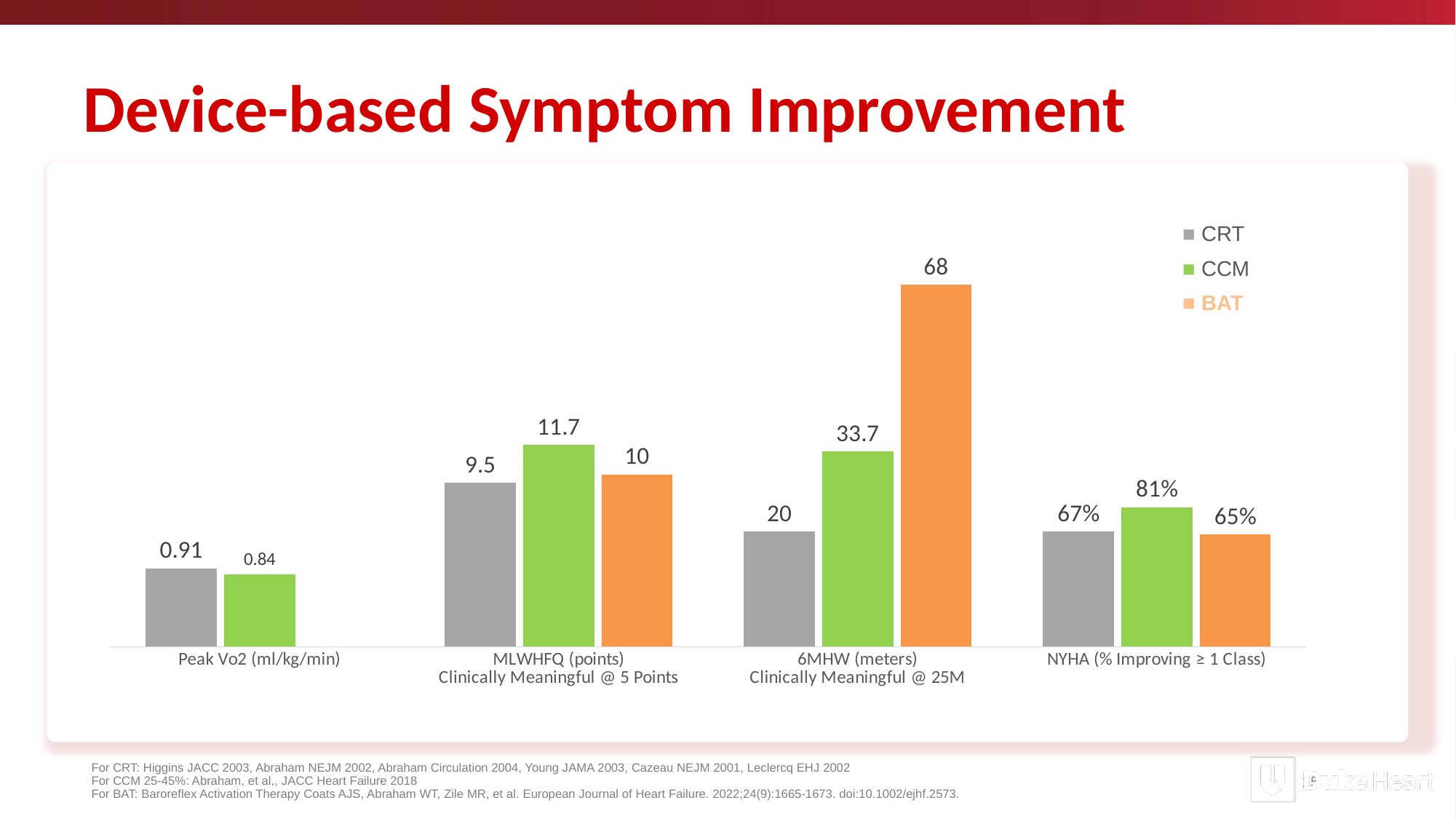
Which series has the highest value for 6MHW (meters)? BAT How many series does the legend list? 3 Which series has the lowest value for NYHA (% Improving ≥ 1 Class)? BAT What is the CCM value for MLWHFQ (points)? 11.7 What is the BAT value for 6MHW (meters)? 68 What is the difference between the CCM and CRT values for NYHA (% Improving ≥ 1 Class)? 14% What is the CRT value for Peak Vo2 (ml/kg/min)? 0.91 What is the difference between the BAT and CRT values for 6MHW (meters)? 48 How many categories are shown on the x axis? 4 What kind of chart is shown on the slide? Bar chart What is the CCM value for NYHA (% Improving ≥ 1 Class)? 81% For MLWHFQ (points), which is larger: the CCM value or the BAT value? CCM